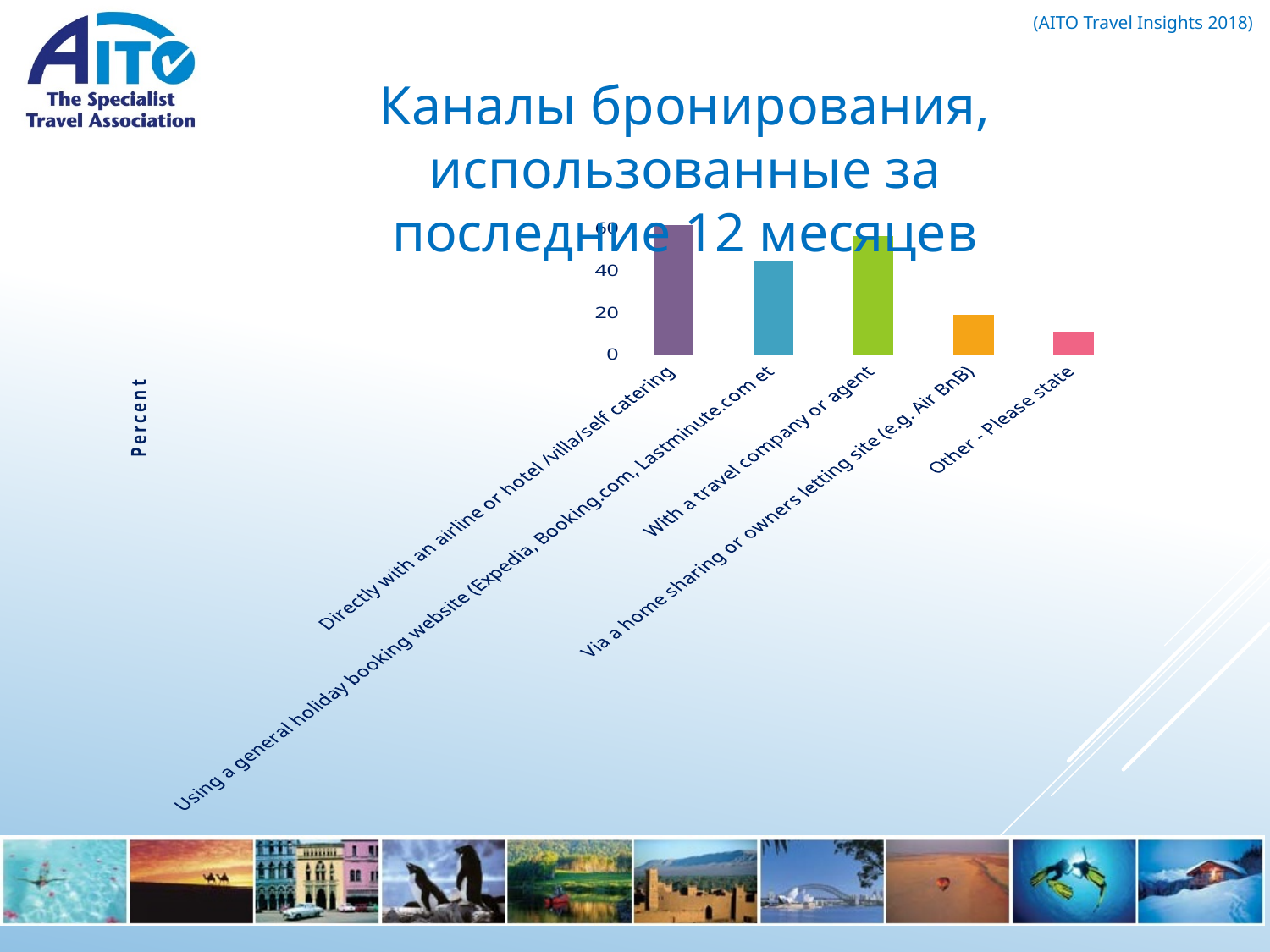
Is the value for 'Other - Please state' greater or less than 20? less What is the highest tick value shown on the vertical axis of the chart? 60 What is the label on the vertical axis of the chart? Percent Which booking channel has the lowest value in the chart? Other - Please state Is the value for 'With a travel company or agent' greater or less than 40? greater Is the value for 'Using a general holiday booking website (Expedia, Booking.com, Lastminute.com et' greater or less than 20? greater Which is larger: the value for 'Directly with an airline or hotel /villa/self catering' or the value for 'Other - Please state'? Directly with an airline or hotel /villa/self catering How many booking channel categories are plotted in the chart? 5 Which is larger: the value for 'With a travel company or agent' or the value for 'Via a home sharing or owners letting site (e.g. Air BnB)'? With a travel company or agent What kind of chart is shown on the slide? bar chart